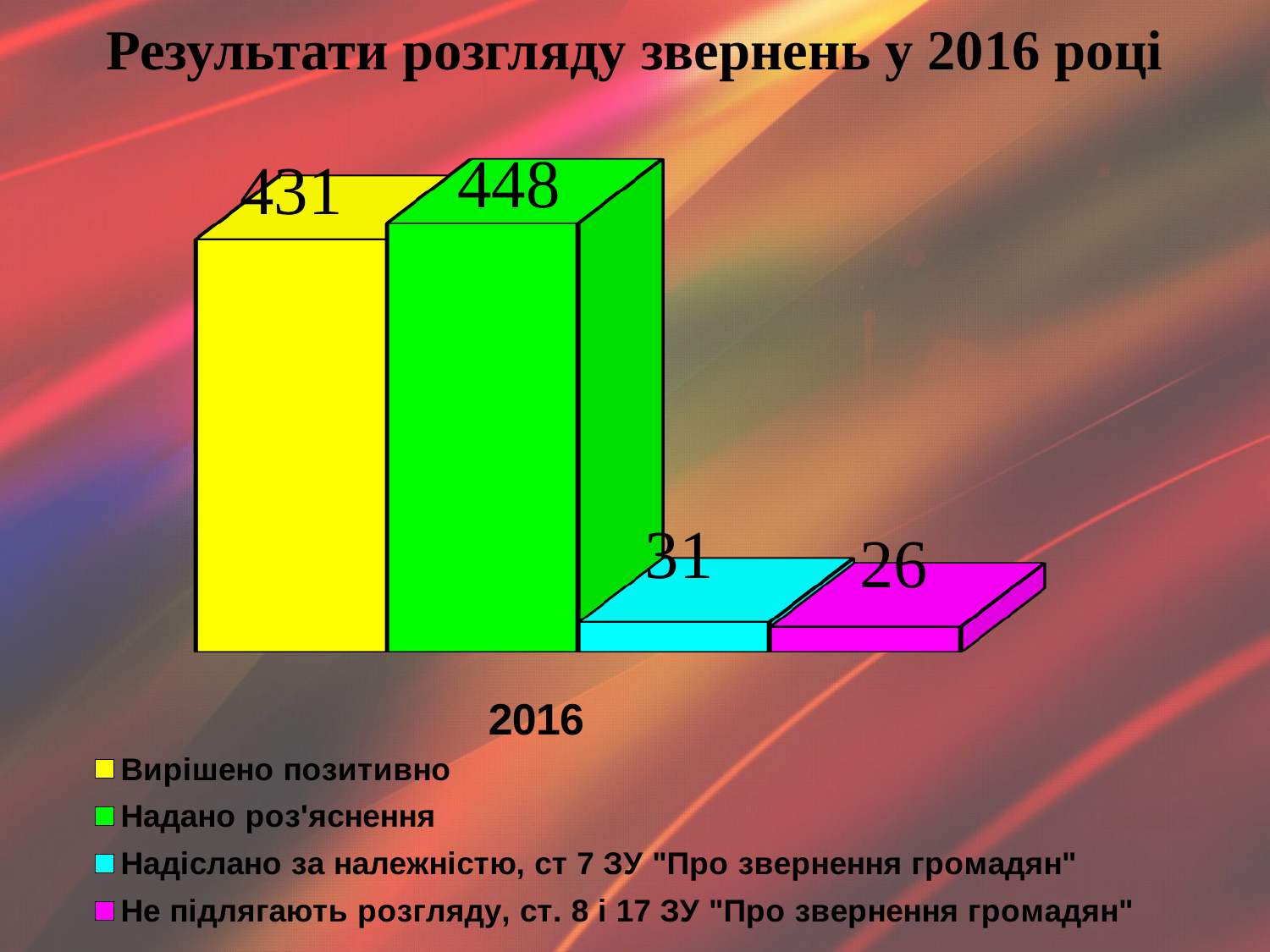
What value is shown for "Не підлягають розгляду, ст. 8 і 17 ЗУ "Про звернення громадян""? 26 What value is shown for "Вирішено позитивно" in 2016? 431 Which series has the lowest value in 2016? Не підлягають розгляду, ст. 8 і 17 ЗУ "Про звернення громадян" Which series has the highest value in 2016? Надано роз'яснення What is the difference between the values for "Надано роз'яснення" and "Вирішено позитивно"? 17 What is the title of the chart on the slide? Результати розгляду звернень у 2016 році What kind of chart is shown on the slide? Bar chart What is the difference between the values for "Надіслано за належністю" and "Не підлягають розгляду"? 5 Which is larger: the value for "Вирішено позитивно" or the value for "Надіслано за належністю"? Вирішено позитивно What value is shown for "Надано роз'яснення" in 2016? 448 What value is shown for "Надіслано за належністю, ст 7 ЗУ "Про звернення громадян""? 31 How many series does the legend list? 4